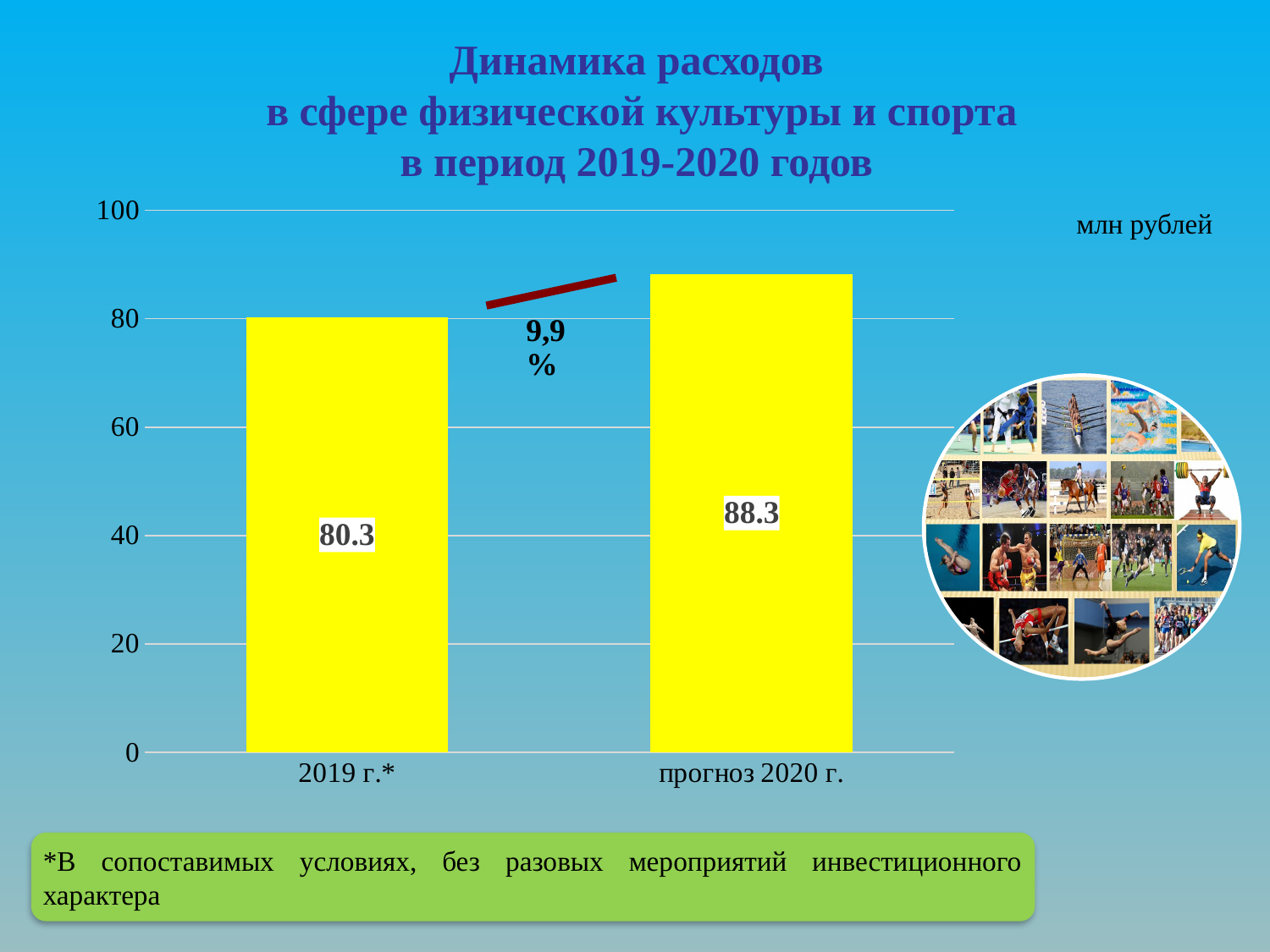
What is the value for 2019 г.*? 80.3 How many categories are shown on the x axis? 2 Do the values rise or fall from 2019 г.* to прогноз 2020 г.? rise Which category has the lowest value? 2019 г.* What is the value for прогноз 2020 г.? 88.3 Is the value for прогноз 2020 г. greater or less than 80? greater What unit is indicated for the chart values? млн рублей Which category has the highest value? прогноз 2020 г. What kind of chart is shown on the slide? bar chart What percentage change is annotated between the two bars? 9,9 % Which is larger, the value for 2019 г.* or the value for прогноз 2020 г.? прогноз 2020 г. What is the difference between the values for прогноз 2020 г. and 2019 г.*? 8.0